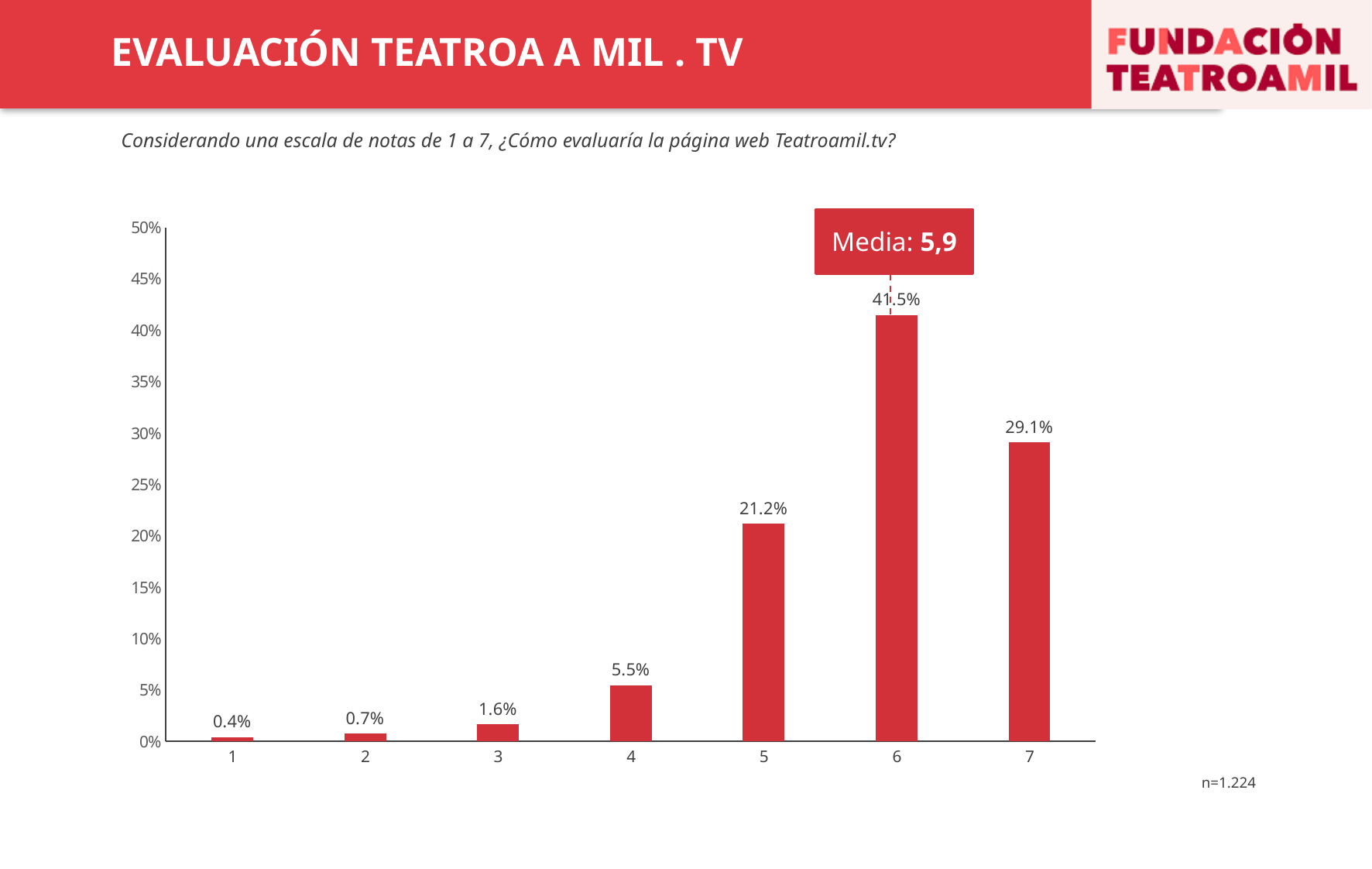
Is the value for rating 5 greater or less than 20%? greater Which rating received the highest percentage of responses? 6 What mean (Media) value is shown in the box above the chart? 5,9 How many rating categories are shown on the x axis? 7 What kind of chart is shown on the slide? bar chart Which has a larger percentage, rating 5 or rating 7? 7 Which rating received the lowest percentage of responses? 1 Do the values rise or fall from rating 1 to rating 6? rise What percentage of respondents gave a rating of 7? 29.1% What percentage of respondents gave the Teatroamil.tv website a rating of 6? 41.5% What is the difference between the percentages for rating 6 and rating 7? 12.4% What is the value shown for rating 4? 5.5%